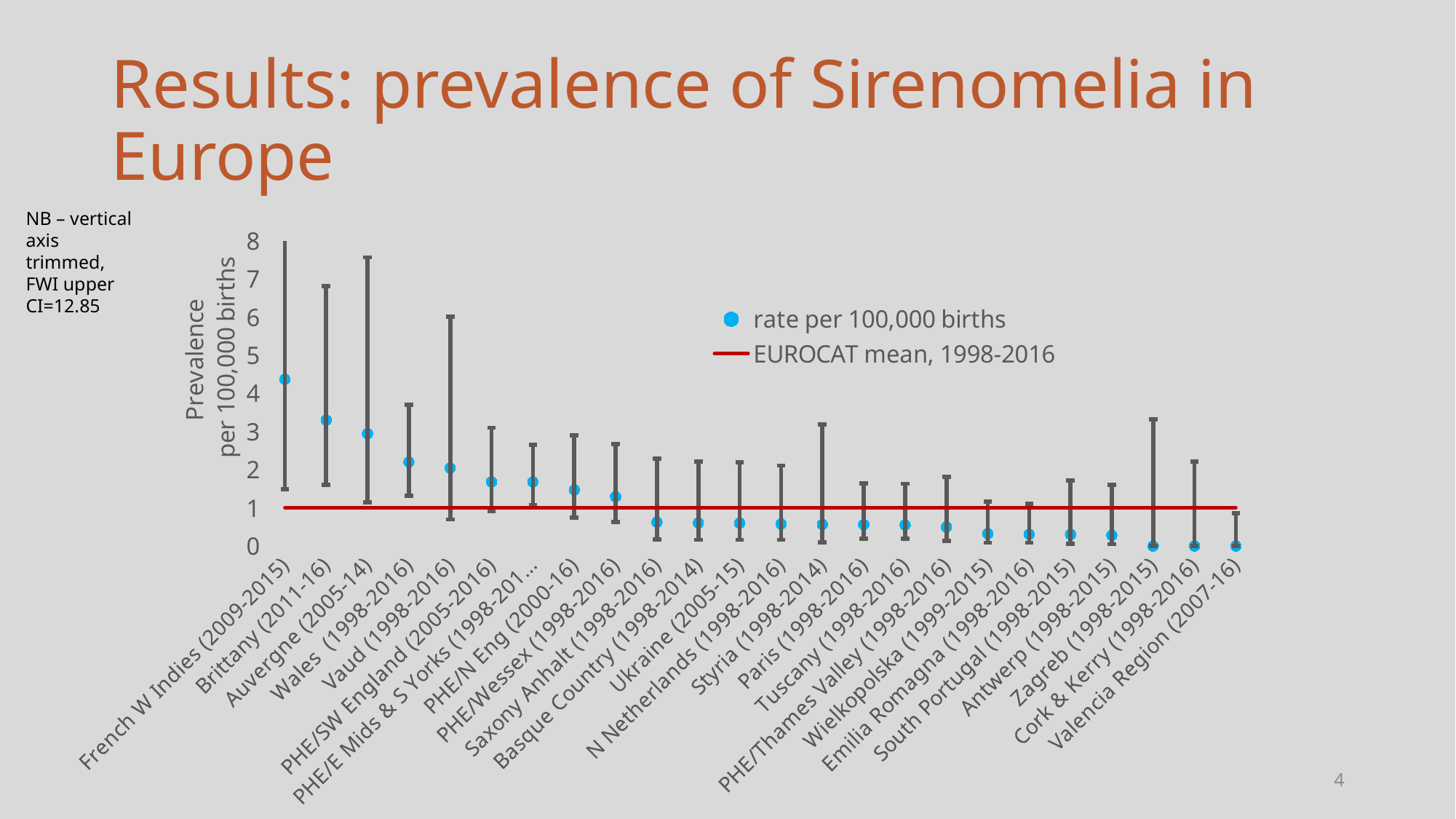
How many series does the legend list? 2 Which region has the highest rate per 100,000 births? French W Indies (2009-2015) What does the red horizontal line in the chart represent, according to the legend? EUROCAT mean, 1998-2016 Do the rates per 100,000 births rise or fall moving from left to right along the x axis? fall Is the rate per 100,000 births for Brittany (2011-16) greater or less than 3? greater Which has the higher rate per 100,000 births, Wales (1998-2016) or Saxony Anhalt (1998-2016)? Wales (1998-2016) Is the rate per 100,000 births for Wales (1998-2016) greater or less than 2? greater Is the rate per 100,000 births for French W Indies (2009-2015) greater or less than 4? greater How many regions (categories) are plotted along the x axis? 24 What kind of chart is shown on the slide? scatter chart with error bars Which has the higher rate per 100,000 births, French W Indies (2009-2015) or Brittany (2011-16)? French W Indies (2009-2015)